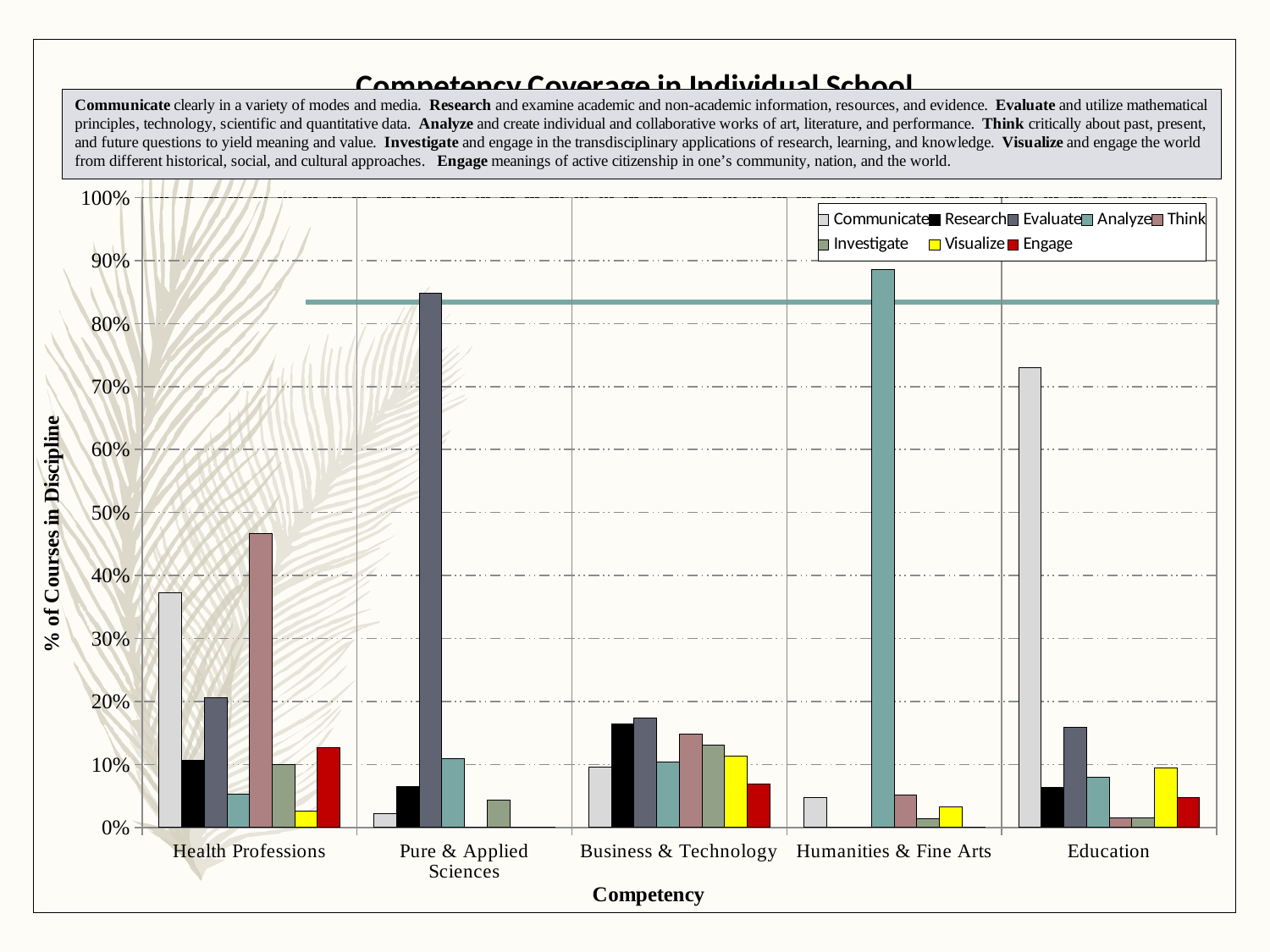
What is the label of the x axis? Competency Is the value for Evaluate in Pure & Applied Sciences greater or less than 80%? greater Which competency has the highest value in Education? Communicate What is the label of the y axis? % of Courses in Discipline Is the value for Think in Health Professions greater or less than 40%? greater Is the value for Analyze in Humanities & Fine Arts greater or less than 80%? greater How many discipline categories are shown along the x axis? 5 How many series does the legend list? 8 Which competency has the highest value in Health Professions? Think Which is larger, the Communicate value for Education or the Communicate value for Health Professions? Education What kind of chart is shown on the slide? bar chart